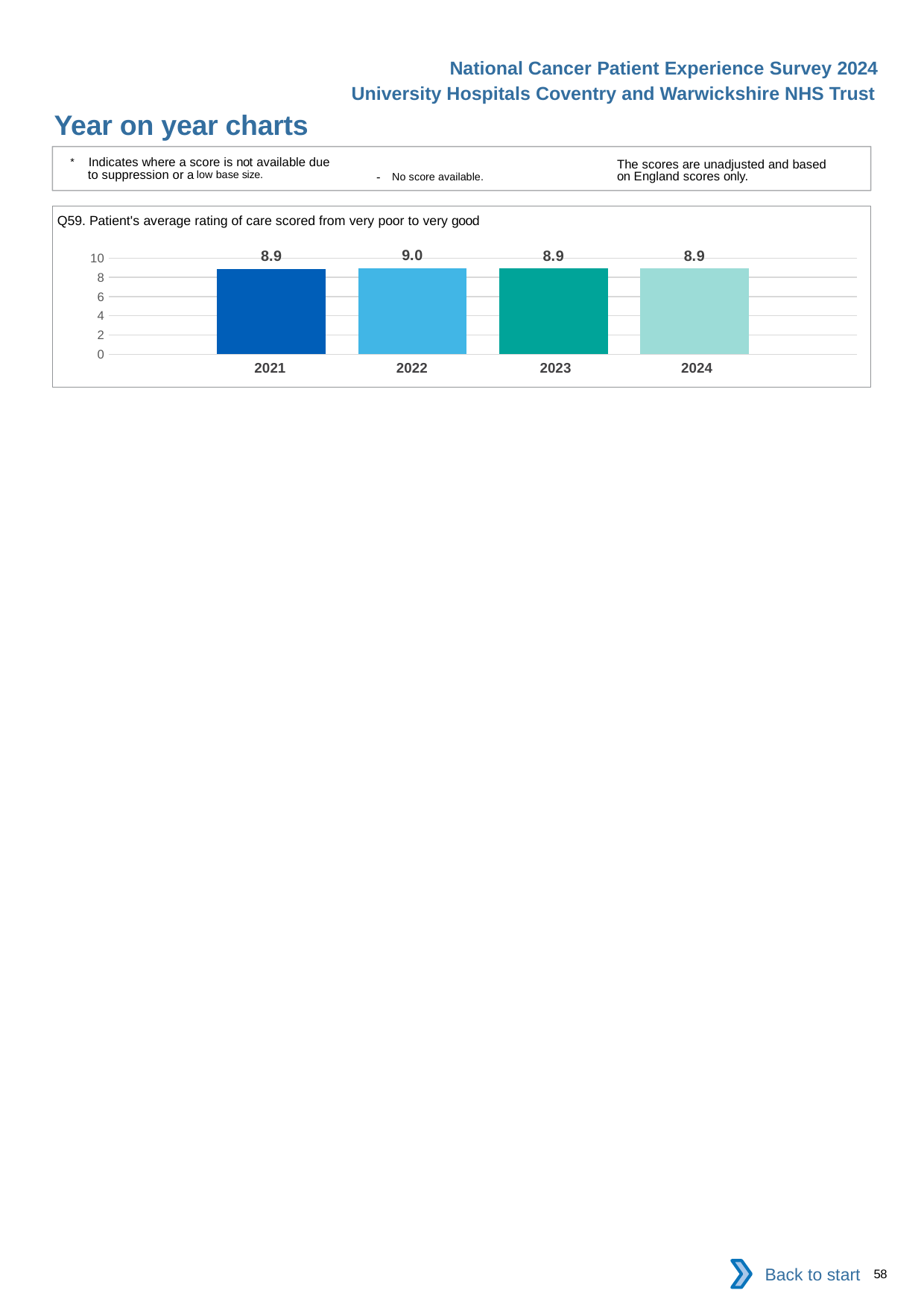
Does the value rise or fall from 2022 to 2023? Fall Is the value for 2022 larger than the value for 2021? Yes Which year has the highest value? 2022 What is the value for 2022? 9.0 How many years are shown on the chart? 4 What kind of chart is shown? Bar chart What is the title of the chart? Q59. Patient's average rating of care scored from very poor to very good What is the value for 2024? 8.9 Is the value for 2023 greater or less than 6? greater What is the maximum value shown on the y axis? 10 What is the difference between the values for 2022 and 2023? 0.1 What is the value for 2021? 8.9